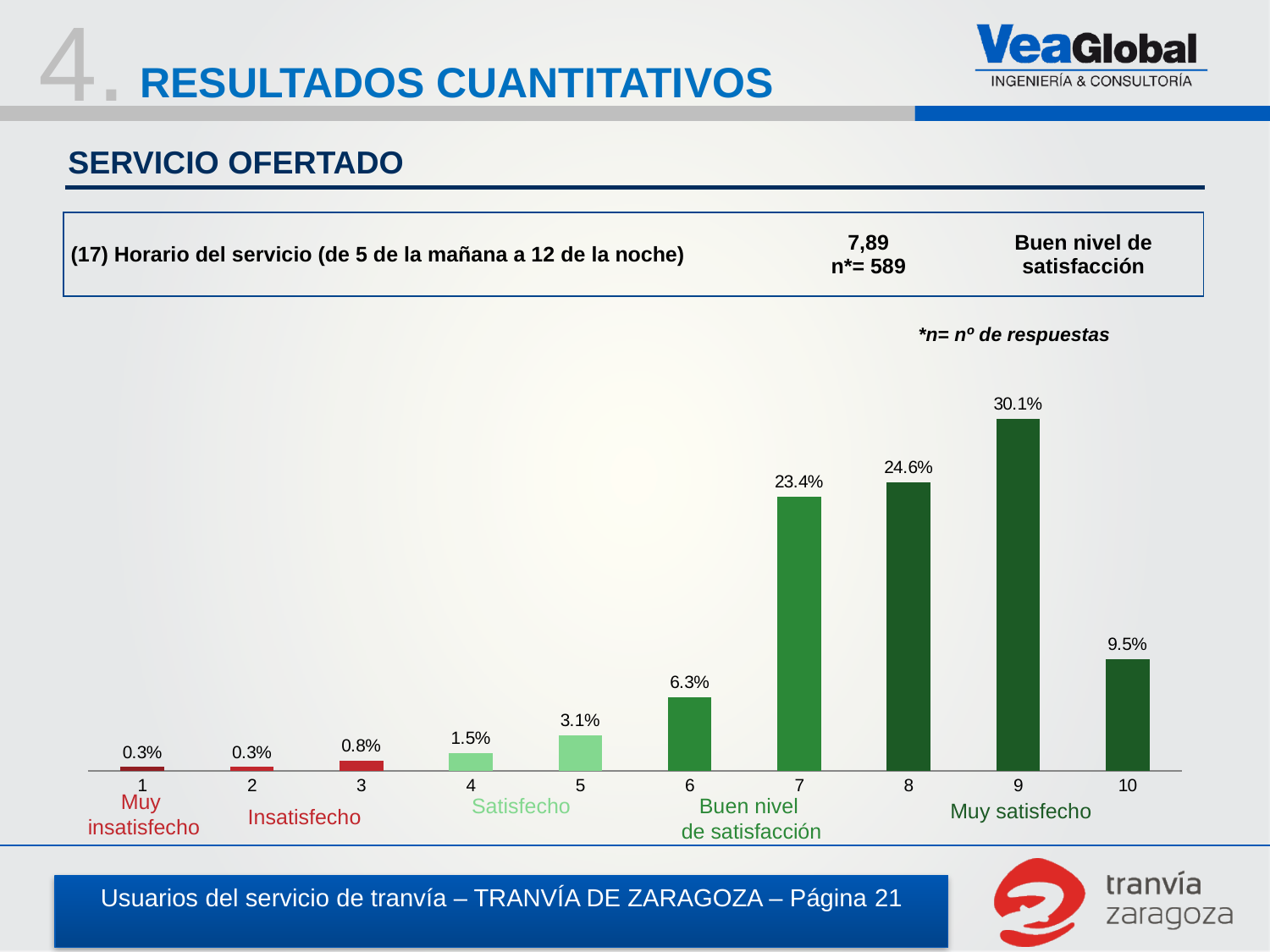
Which is larger, the value for category 8 or the value for category 10? 8 How many categories are shown on the x axis? 10 What is the value for category 10? 9.5% What kind of chart is shown on the slide? bar chart What is the difference between the values for categories 6 and 5? 3.2% What label is shown under categories 1 on the x axis? Muy insatisfecho What is the value for category 4? 1.5% Which category has the highest value? 9 Do the values rise or fall from category 1 to category 9? rise What is the difference between the values for categories 9 and 8? 5.5% What is the value for category 9? 30.1% What is the value for category 7? 23.4%